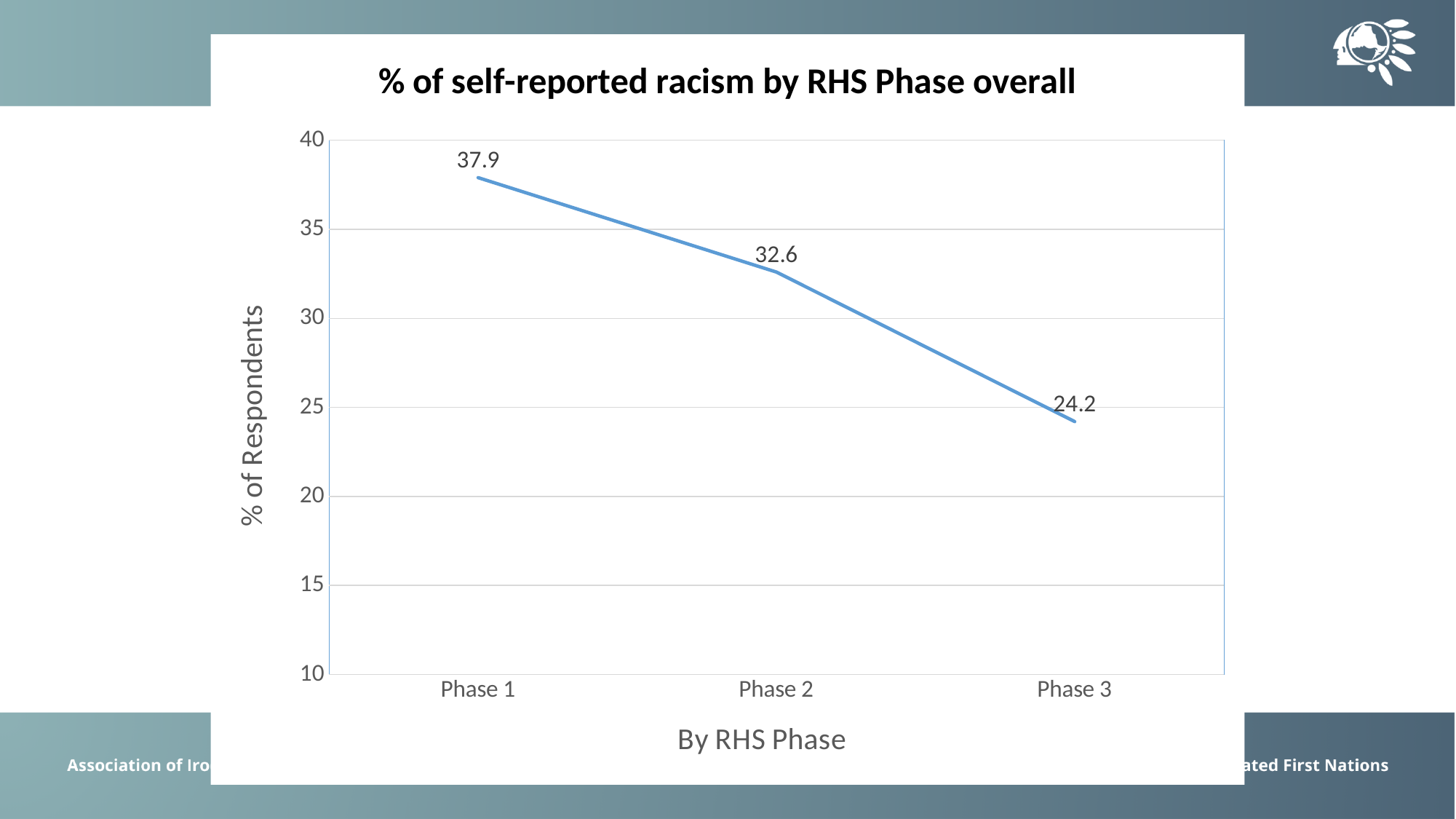
Which is larger, the value for Phase 2 or the value for Phase 3? Phase 2 Do the values rise or fall from Phase 1 to Phase 3? Fall What is the value for Phase 3? 24.2 Which phase has the lowest % of respondents reporting racism? Phase 3 What is the value for Phase 1? 37.9 Is the value for Phase 2 greater or less than 30? greater What is the value for Phase 2? 32.6 What is the difference between the values for Phase 1 and Phase 3? 13.7 How many phases are plotted on the chart? 3 Which phase has the highest % of respondents reporting racism? Phase 1 What is the difference between the values for Phase 1 and Phase 2? 5.3 What kind of chart is shown on the slide? Line chart